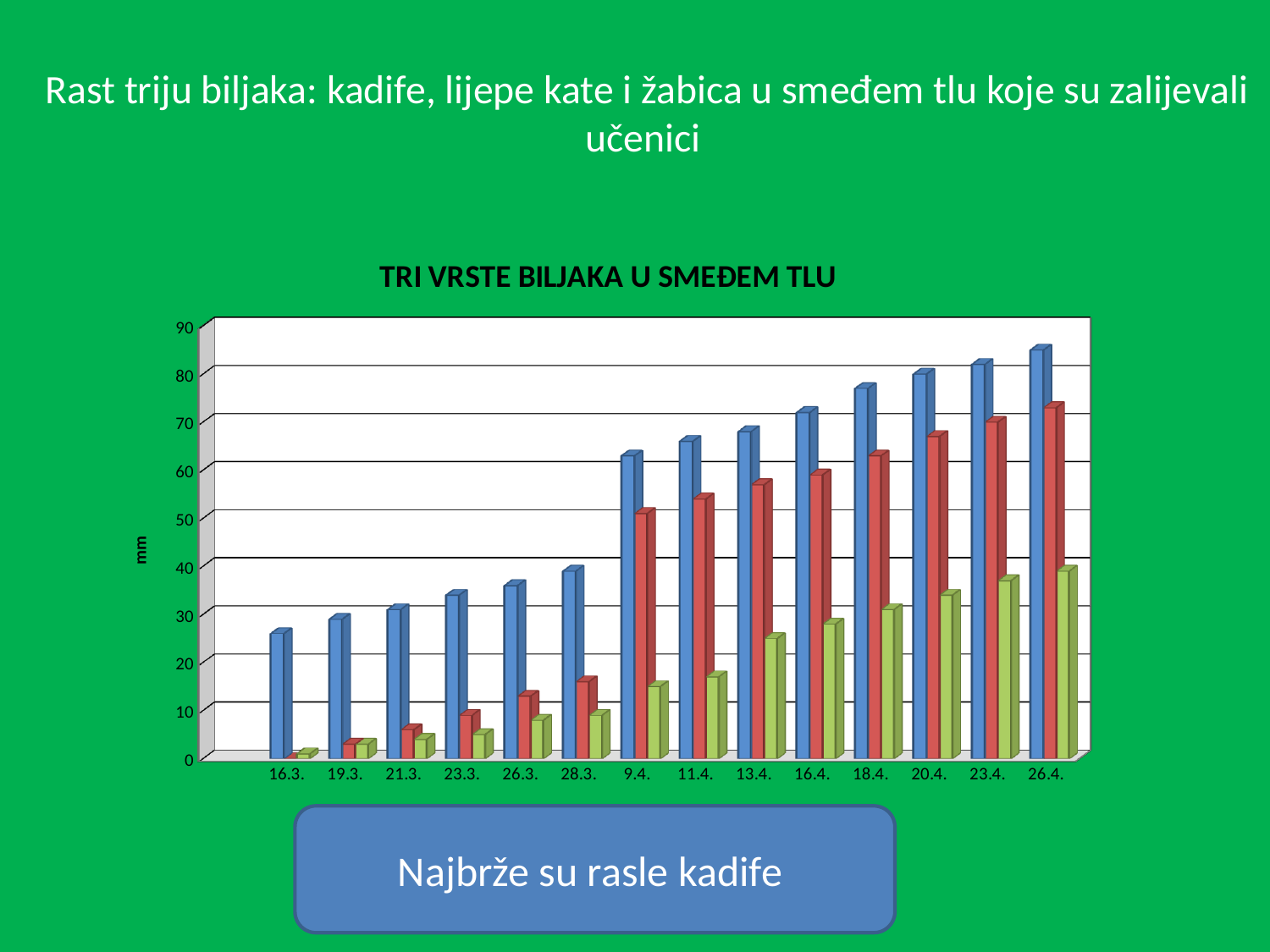
Do the values of the blue bars rise or fall from 16.3. to 26.4.? rise Is the value of the blue bar for 16.3. greater or less than 20? greater How many dates (categories) are shown on the x axis of the chart? 14 On 26.4., which bar is taller, the blue bar or the red bar? the blue bar What is the label on the vertical axis of the chart? mm Is the value of the green bar for 16.3. greater or less than 10? less On which date is the green bar the shortest? 16.3. On which date is the blue bar the tallest? 26.4. What is the title of the chart? TRI VRSTE BILJAKA U SMEĐEM TLU Is the value of the red bar for 26.4. greater or less than 60? greater What type of chart is shown on the slide? bar chart